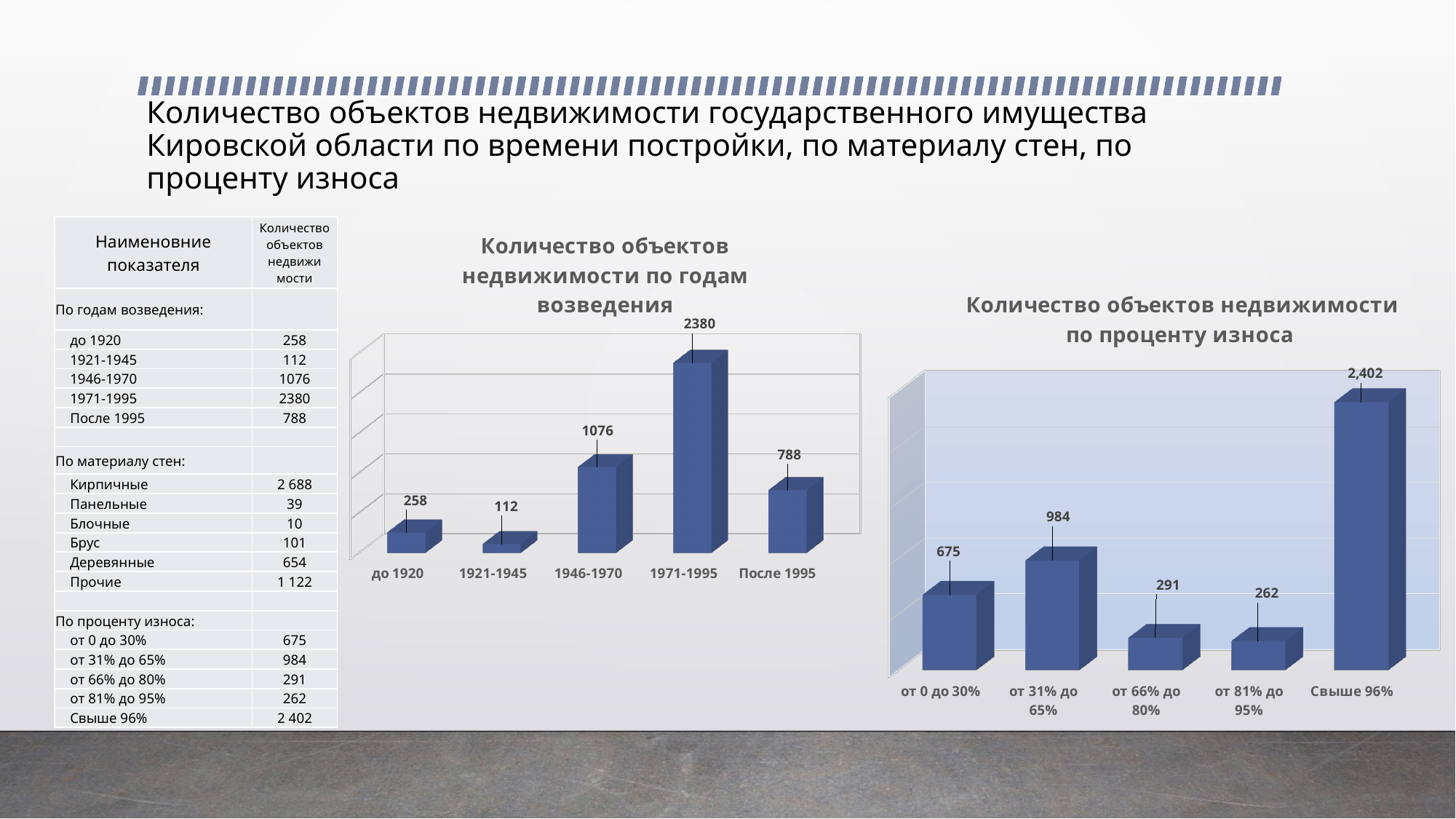
In the chart 'Количество объектов недвижимости по проценту износа', which category has the lowest value? от 81% до 95% In the chart 'Количество объектов недвижимости по проценту износа', what is the difference between the values for от 31% до 65% and от 0 до 30%? 309 In the chart 'Количество объектов недвижимости по годам возведения', how many categories are shown on the x axis? 5 In the chart 'Количество объектов недвижимости по годам возведения', which category has the highest value? 1971-1995 In the chart 'Количество объектов недвижимости по годам возведения', what is the value for до 1920? 258 In the chart 'Количество объектов недвижимости по проценту износа', what is the value for от 31% до 65%? 984 In the chart 'Количество объектов недвижимости по годам возведения', which category has the lowest value? 1921-1945 What type of chart is 'Количество объектов недвижимости по проценту износа'? Bar chart In the chart 'Количество объектов недвижимости по проценту износа', which category has the highest value? Свыше 96% In the chart 'Количество объектов недвижимости по годам возведения', what is the difference between the values for 1971-1995 and После 1995? 1592 In the chart 'Количество объектов недвижимости по проценту износа', which is larger: the value for от 0 до 30% or the value for от 66% до 80%? от 0 до 30% In the chart 'Количество объектов недвижимости по годам возведения', what is the value for 1946-1970? 1076